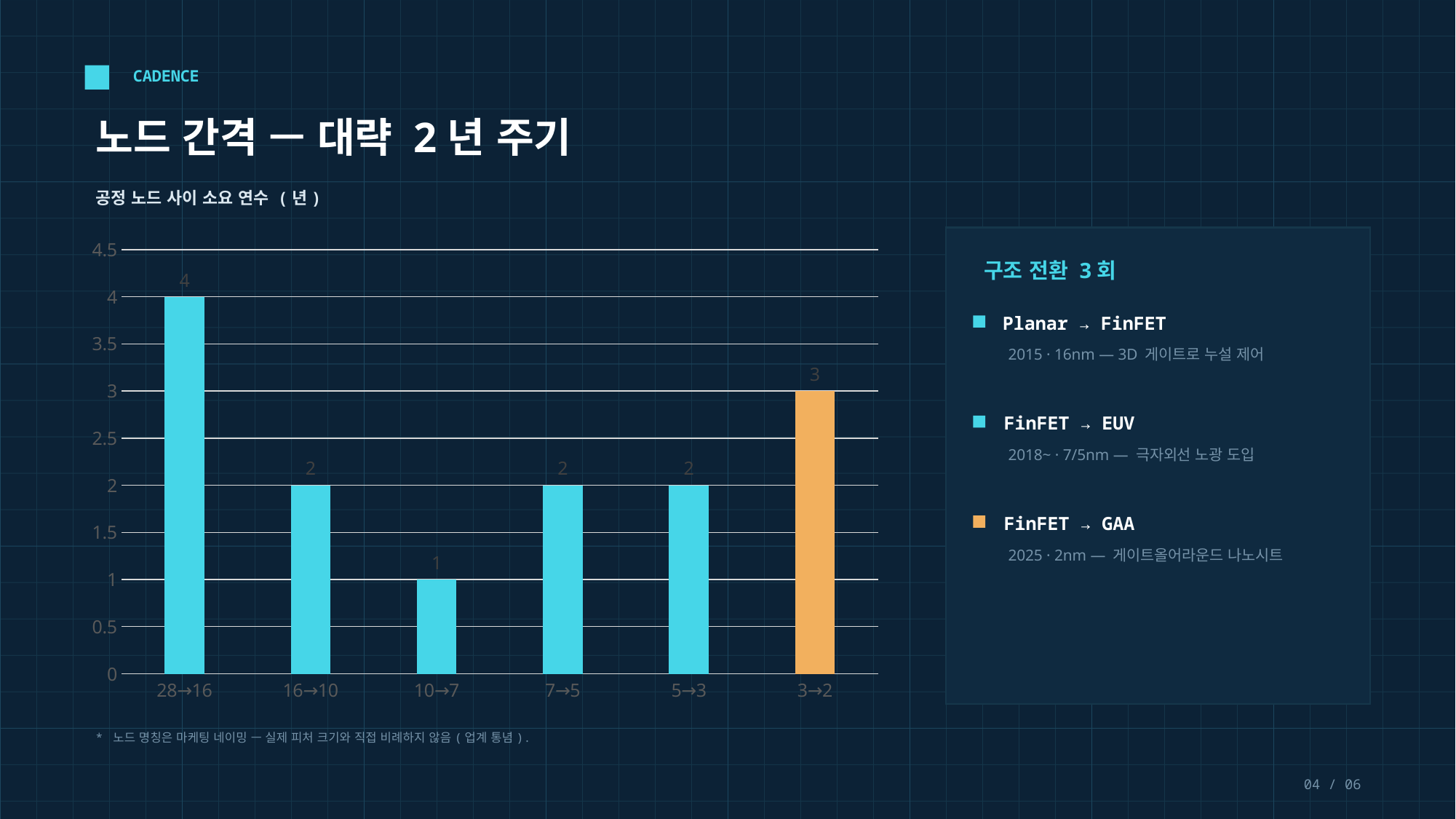
What is the value for the 10→7 node transition? 1 What is the value for the 28→16 node transition? 4 How many node transitions have a value of 2? 3 What kind of chart is shown on the slide? bar chart Which node transition has the lowest value? 10→7 How many node transitions are shown on the x axis? 6 Is the value for 28→16 greater or less than 3.5? greater What is the value for the 3→2 node transition? 3 Which node transition has the highest value? 28→16 Which is larger, the value for 16→10 or the value for 3→2? 3→2 What is the difference between the values for 28→16 and 3→2? 1 Which bar is coloured orange instead of cyan? 3→2